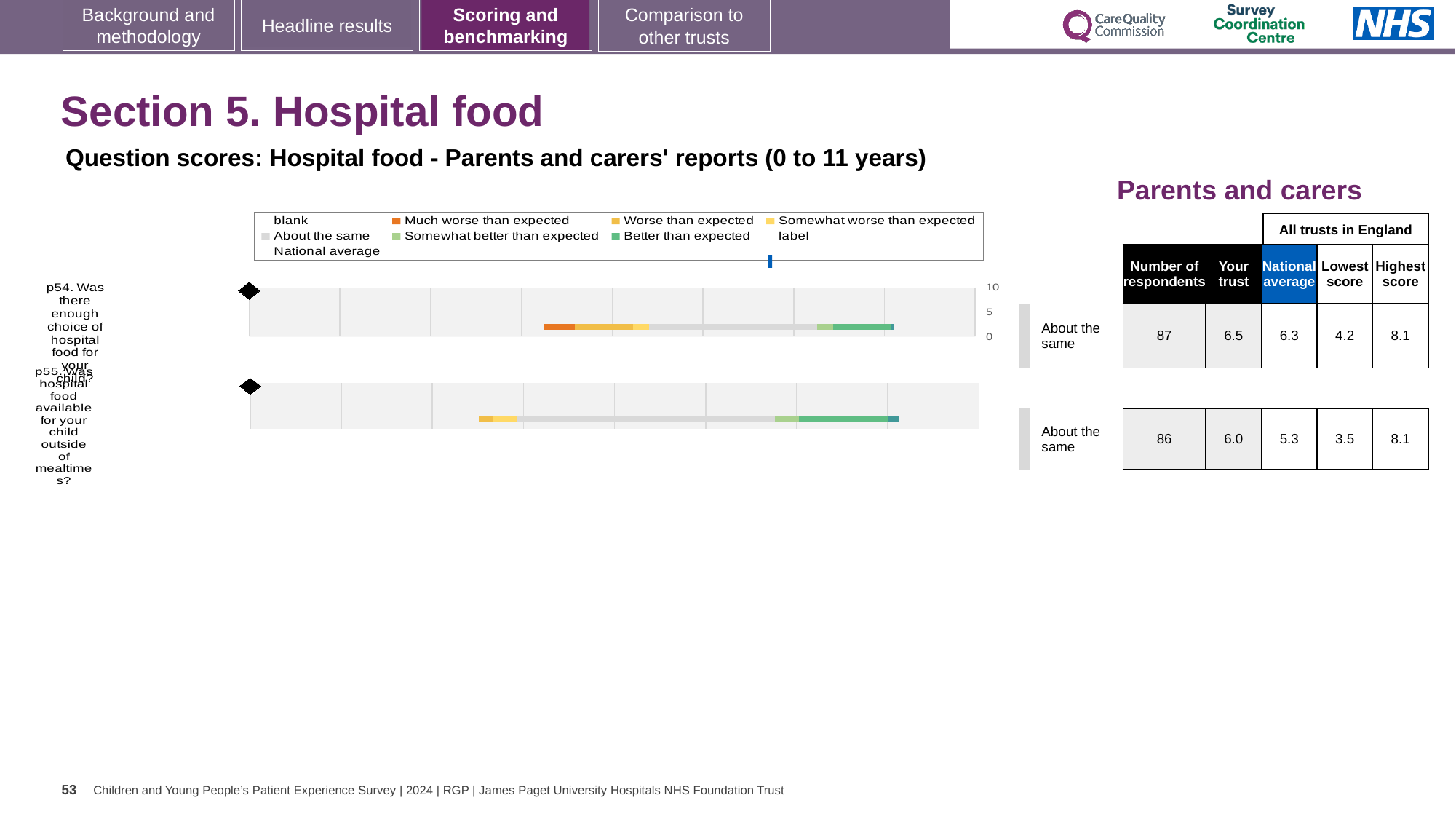
What benchmark category is shown for p55 (hospital food available outside of mealtimes)? About the same How many respondents answered p54 (enough choice of hospital food)? 87 Which colour does the legend use for 'Much worse than expected'? orange What is the lowest score among all trusts in England for p55? 3.5 How many entries does the legend of the hospital food chart list? 9 What kind of chart is used to show the question scores for hospital food? bar chart What is the national average score for p55 (hospital food available outside of mealtimes)? 5.3 Which question has the higher 'Your trust' score, p54 or p55? p54 What is the highest score among all trusts in England for p54? 8.1 What is the 'Your trust' score for p54 (enough choice of hospital food for your child)? 6.5 What is the difference between the 'Your trust' score and the national average for p54? 0.2 How many survey questions are plotted in the hospital food chart? 2